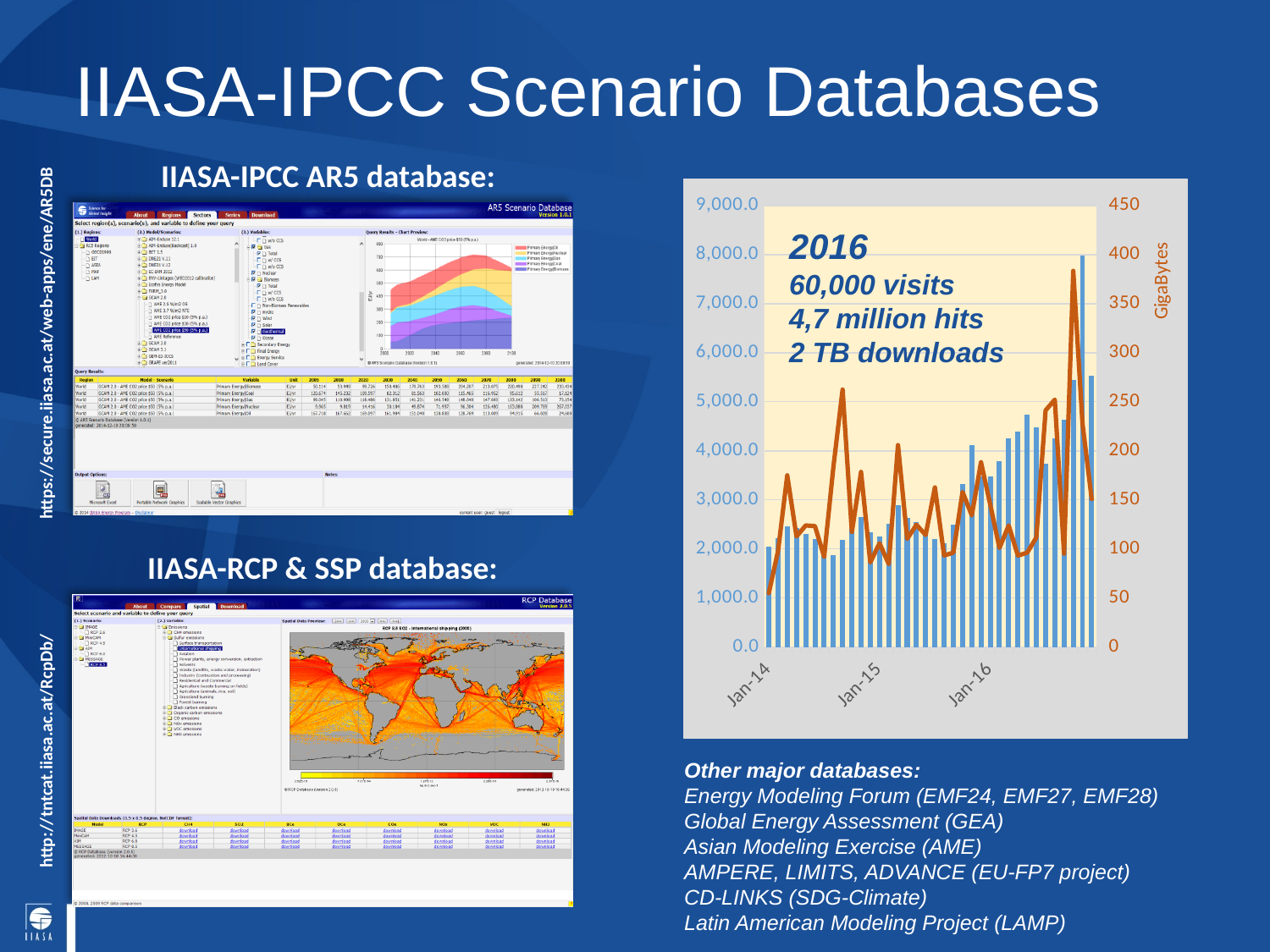
According to the annotation on the chart, how many visits were there in 2016? 60,000 visits Is the highest point of the orange line greater or less than 350 on the right axis? greater Which blue bar is taller, the one at Jan-14 or the one at Jan-16? Jan-16 Is the blue bar at Jan-14 greater or less than 3,000.0 on the left axis? less What kind of chart is shown on the right side of the slide? bar and line chart According to the annotation on the chart, how many hits were there in 2016? 4,7 million hits Which year is annotated in the text box inside the chart? 2016 What is the label on the right-hand vertical axis of the chart? GigaBytes Is the tallest blue bar in the chart greater or less than 7,000.0 on the left axis? greater How many month labels are shown on the x axis of the chart? 3 Do the blue bars generally rise or fall from Jan-14 to Jan-16? rise According to the annotation on the chart, how much data was downloaded in 2016? 2 TB downloads